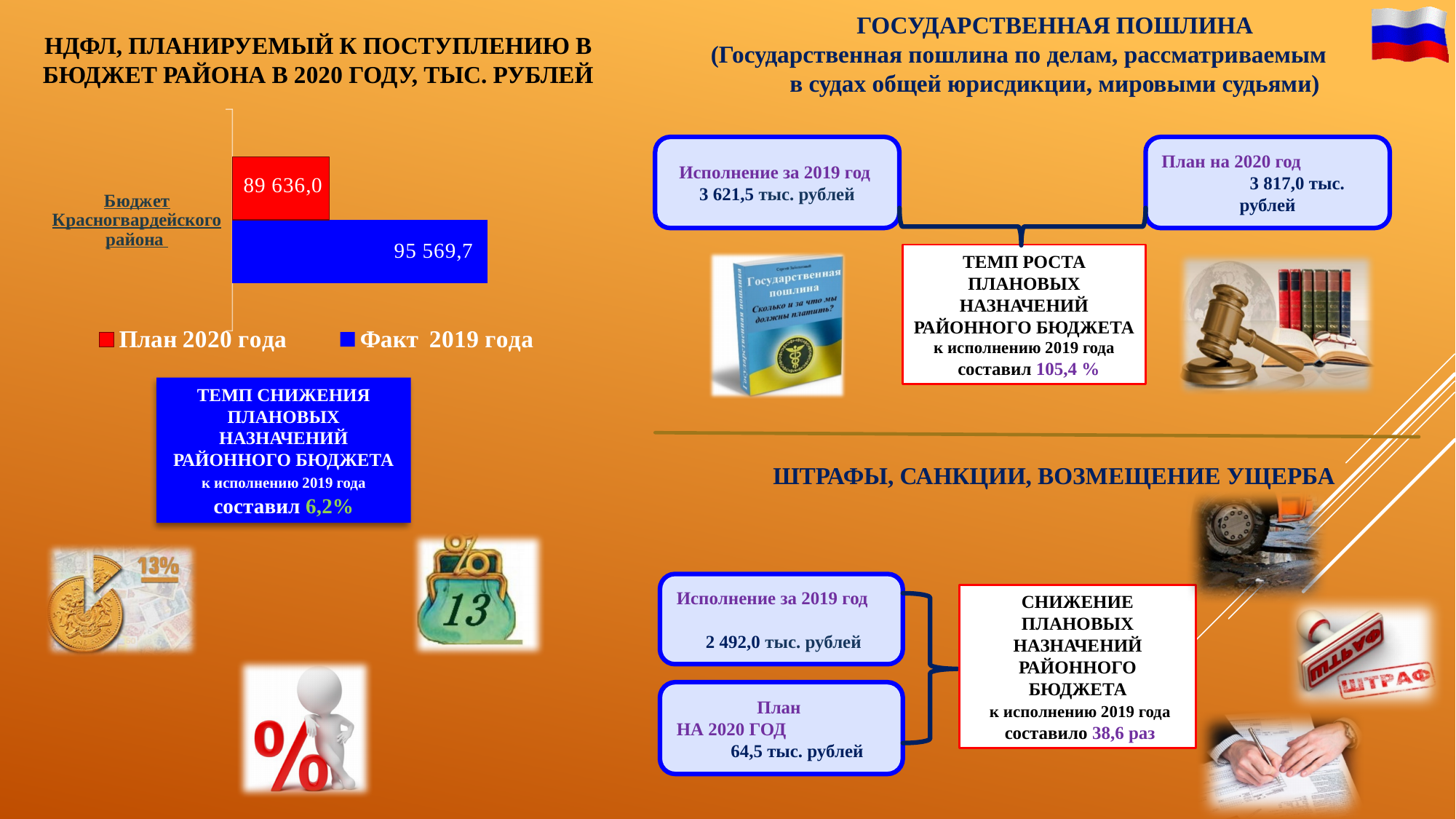
How many series does the chart legend list? 2 Which series has the highest value in the chart? Факт 2019 года What is the category label shown on the chart's axis? Бюджет Красногвардейского района What is the value for План 2020 года in the chart? 89 636,0 What colour is the bar for План 2020 года in the chart? red What is the value for Факт 2019 года in the chart? 95 569,7 What is the difference between the Факт 2019 года value and the План 2020 года value in the chart? 5 933,7 What type of chart is shown on the slide? bar chart How many categories are shown on the chart's category axis? 1 Which series has the higher value in the chart, План 2020 года or Факт 2019 года? Факт 2019 года Which series has the lowest value in the chart? План 2020 года